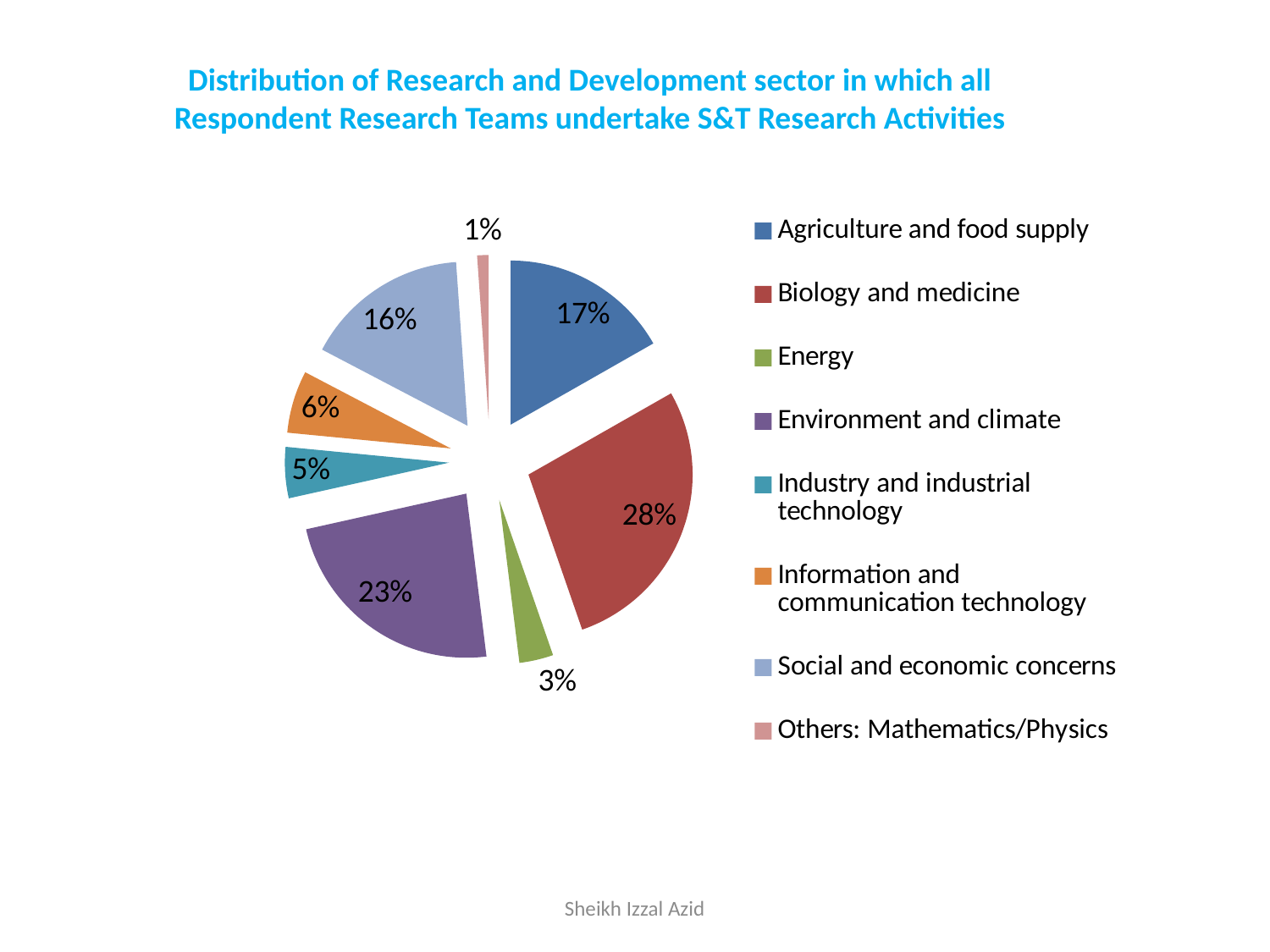
What percentage is shown for Social and economic concerns? 16% What colour is the slice for Environment and climate? Purple Which sector has the smallest share of the pie? Others: Mathematics/Physics What percentage is shown for Environment and climate? 23% What is the difference in percentage points between Biology and medicine and Environment and climate? 5 Which has a larger share, Industry and industrial technology or Information and communication technology? Information and communication technology Which sector has the largest share of the pie? Biology and medicine What share of the pie does Biology and medicine have? 28% What percentage is shown for Energy? 3% What kind of chart is shown on the slide? Pie chart How many sectors are shown in the pie chart? 8 What percentage is shown for Agriculture and food supply? 17%